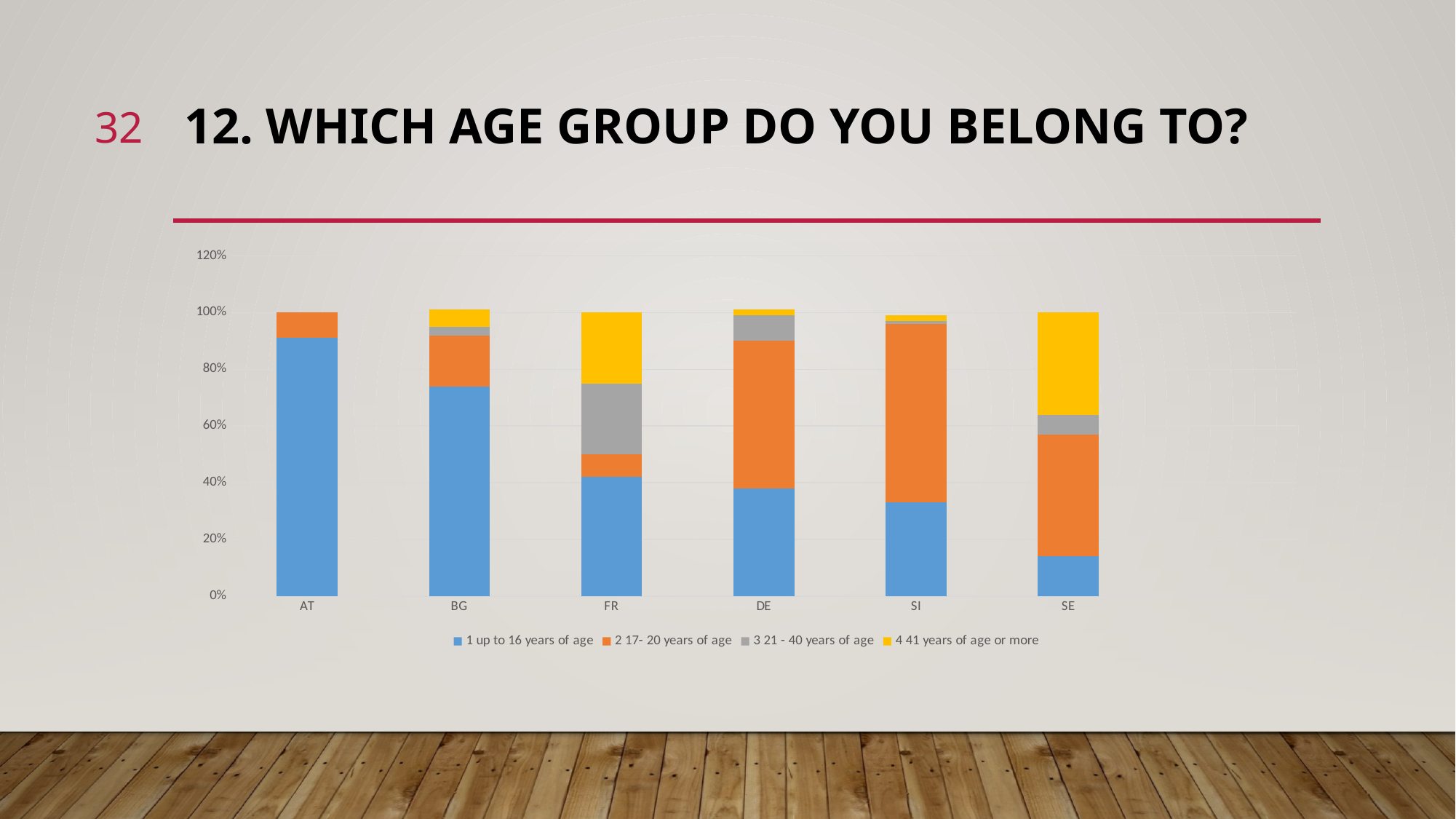
Which country has the largest share of respondents in the '1 up to 16 years of age' group? AT Which has a larger '1 up to 16 years of age' share, AT or BG? AT What kind of chart is shown on the slide? Stacked bar chart Which country has the smallest share of respondents in the '1 up to 16 years of age' group? SE How many countries are shown on the x axis of the chart? 6 What colour represents the '2 17- 20 years of age' series in the chart? Orange Is the '1 up to 16 years of age' share for BG greater or less than 60%? greater Which country has the largest share of respondents in the '4 41 years of age or more' group? SE Is the '1 up to 16 years of age' share for SE greater or less than 20%? less How many series does the chart legend list? 4 Which has a larger '4 41 years of age or more' share, SE or FR? SE Is the '1 up to 16 years of age' share for AT greater or less than 80%? greater